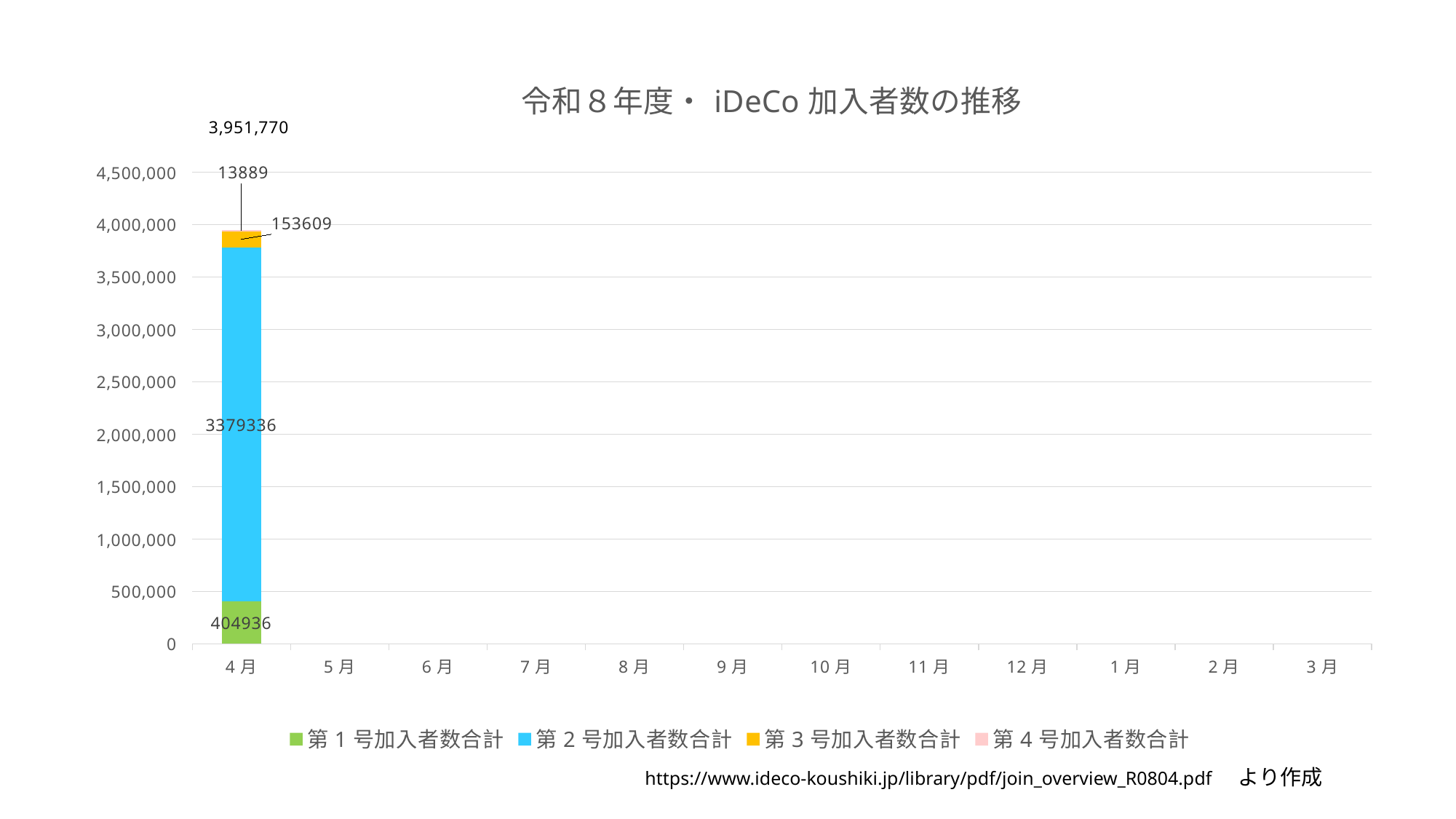
What is the value of 第４号加入者数合計 for 4月? 13889 How many series does the legend list? 4 How many month categories are shown on the x axis? 12 What is the difference between 第１号加入者数合計 and 第３号加入者数合計 for 4月? 251327 What is the total of the stacked bar for 4月? 3,951,770 Which series has the smallest value in the 4月 bar? 第４号加入者数合計 Which series has the largest value in the 4月 bar? 第２号加入者数合計 What is the value of 第２号加入者数合計 for 4月? 3379336 Which is larger for 4月, 第１号加入者数合計 or 第３号加入者数合計? 第１号加入者数合計 What is the value of 第１号加入者数合計 for 4月? 404936 What is the title of the chart? 令和８年度・ iDeCo 加入者数の推移 What is the value of 第３号加入者数合計 for 4月? 153609